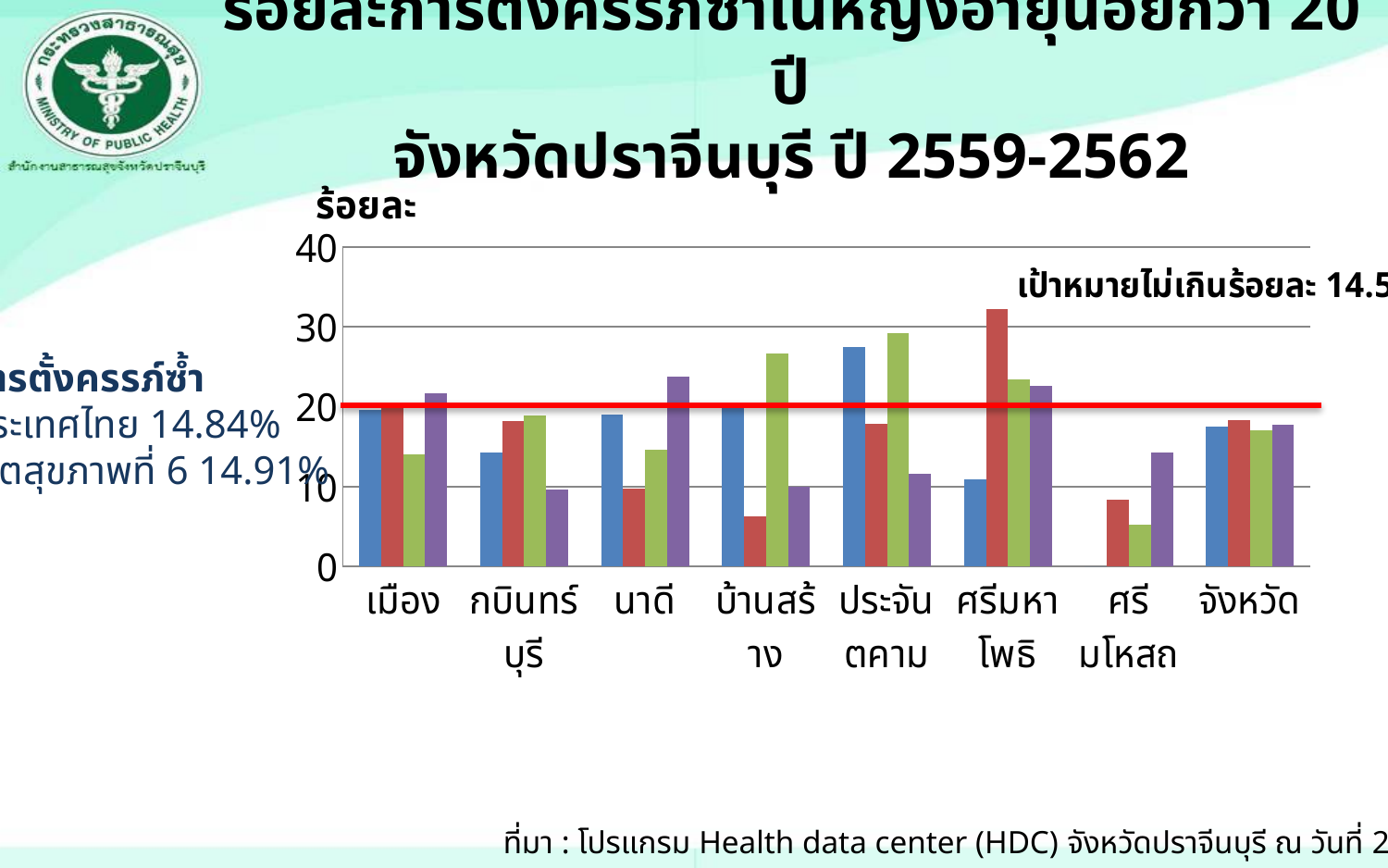
For บ้านสร้าง, which is larger: the green bar or the red bar? green bar Is the value of the red bar for ศรีมหาโพธิ greater or less than 30? greater What is the highest tick value shown on the y axis of the chart? 40 How many bars are plotted for the category เมือง? 4 How many categories are shown along the x axis of the chart? 8 Is the value of the red bar for บ้านสร้าง greater or less than 10? less What kind of chart is shown on the slide? bar chart Is the value of the blue bar for ประจันตคาม greater or less than 20? greater Which category has the tallest bar in the chart? ศรีมหาโพธิ For ศรีมหาโพธิ, which is larger: the red bar or the blue bar? red bar